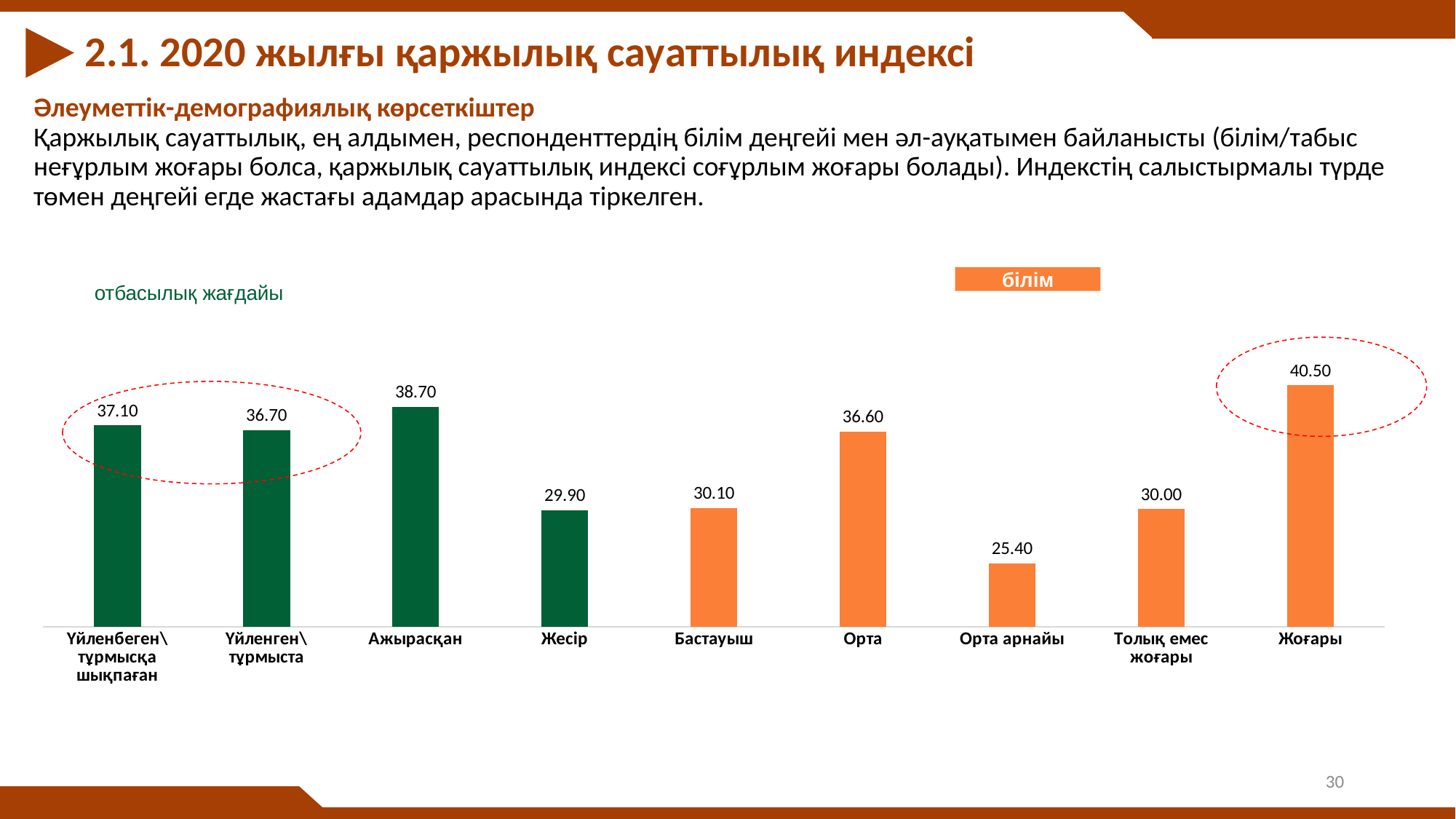
Which is larger, the value for Орта or the value for Бастауыш? Орта What kind of chart is shown on the slide? Bar chart What is the difference between the values for Ажырасқан and Жесір? 8.80 What is the difference between the values for Жоғары and Орта арнайы? 15.10 What is the value for Жоғары? 40.50 Which category has the lowest value on the chart? Орта арнайы Which group of bars is coloured orange, отбасылық жағдайы or білім? білім What is the value for Ажырасқан? 38.70 What is the value for Жесір? 29.90 How many categories are shown on the chart? 9 What is the value for Орта арнайы? 25.40 Which category has the highest value on the chart? Жоғары